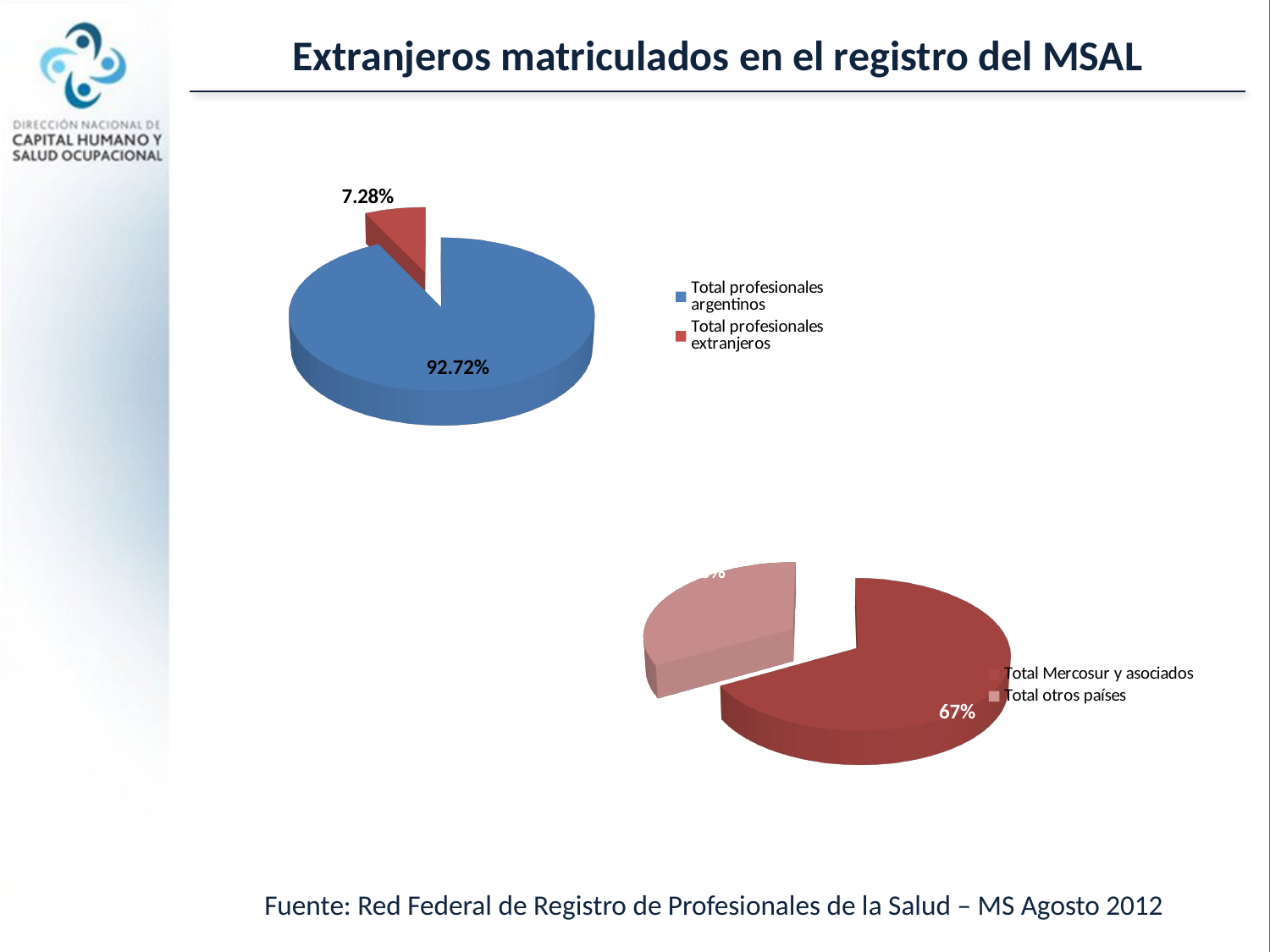
In the bottom-right pie chart, which is larger: Total Mercosur y asociados or Total otros países? Total Mercosur y asociados In the top-left pie chart, what colour is the slice for Total profesionales extranjeros? Red In the top-left pie chart, what share is labelled for Total profesionales argentinos? 92.72% In the bottom-right pie chart, what share is labelled for Total Mercosur y asociados? 67% In the top-left pie chart, which category has the smallest slice? Total profesionales extranjeros In the top-left pie chart, what share is labelled for Total profesionales extranjeros? 7.28% In the bottom-right pie chart, how many categories does the legend list? 2 In the top-left pie chart, how many categories does the legend list? 2 What kind of chart is the top-left chart? Pie chart What is the title of the slide containing the two pie charts? Extranjeros matriculados en el registro del MSAL In the top-left pie chart, what is the difference in percentage points between Total profesionales argentinos and Total profesionales extranjeros? 85.44 In the top-left pie chart, which category has the largest slice? Total profesionales argentinos